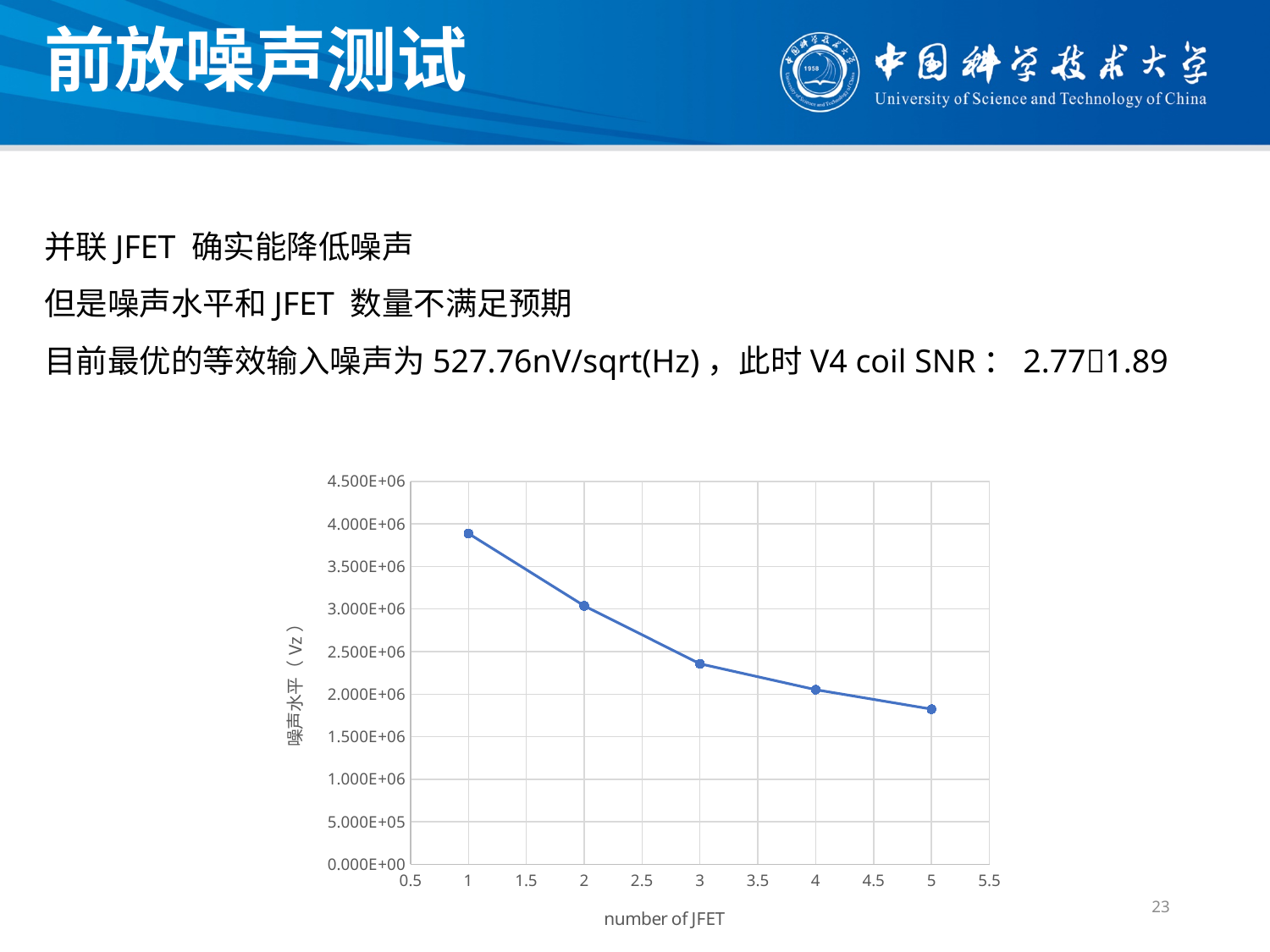
Is the noise level for 2 JFET greater or less than 3.500E+06? less At which number of JFET is the noise level lowest? 5 What kind of chart is shown on the slide? line chart Is the noise level for 3 JFET greater or less than 2.000E+06? greater Is the noise level for 1 JFET greater or less than 3.500E+06? greater Does the noise level rise or fall as the number of JFET increases? fall Which has a higher noise level, 2 JFET or 4 JFET? 2 JFET What is the label of the x axis of the chart? number of JFET What is the label of the y axis of the chart? 噪声水平（Vz） How many data points are plotted on the chart? 5 At which number of JFET is the noise level highest? 1